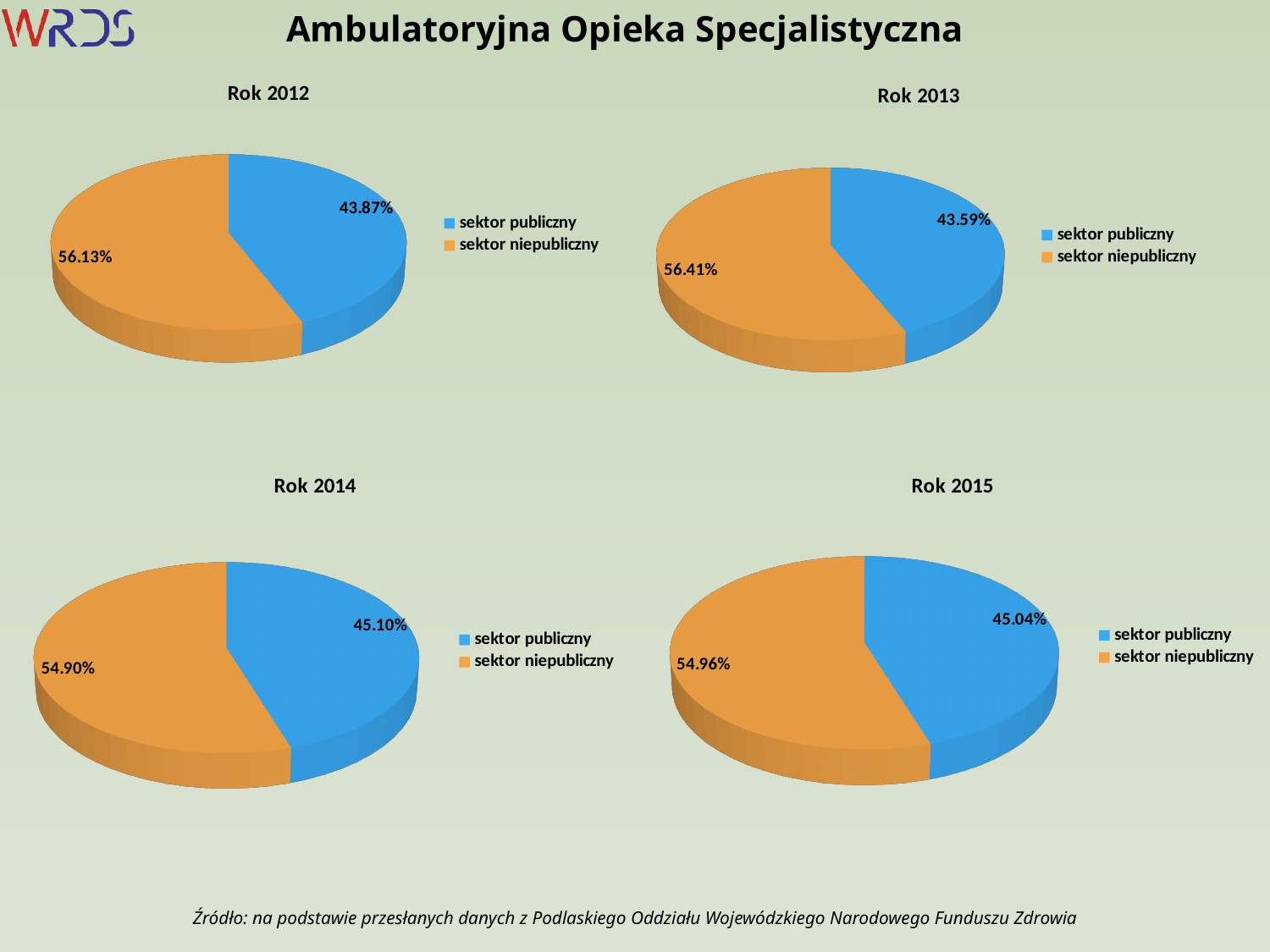
In the 'Rok 2014' pie chart, is the 'sektor publiczny' slice larger or smaller than the 'sektor niepubliczny' slice? smaller In the 'Rok 2015' pie chart, what share does 'sektor niepubliczny' have? 54.96% In the 'Rok 2013' pie chart, what is the difference between the 'sektor niepubliczny' and 'sektor publiczny' shares? 12.82% What colour represents 'sektor publiczny' in the 'Rok 2014' pie chart? blue In the 'Rok 2013' pie chart, what share does 'sektor niepubliczny' have? 56.41% In the 'Rok 2012' pie chart, what share does 'sektor publiczny' have? 43.87% In the 'Rok 2015' pie chart, which sector has the smaller slice? sektor publiczny What type of chart is used for 'Rok 2013'? pie chart How many slices does the 'Rok 2012' pie chart have? 2 How many entries does the legend of the 'Rok 2015' chart list? 2 In the 'Rok 2012' pie chart, which sector has the larger slice? sektor niepubliczny In the 'Rok 2014' pie chart, what share does 'sektor publiczny' have? 45.10%